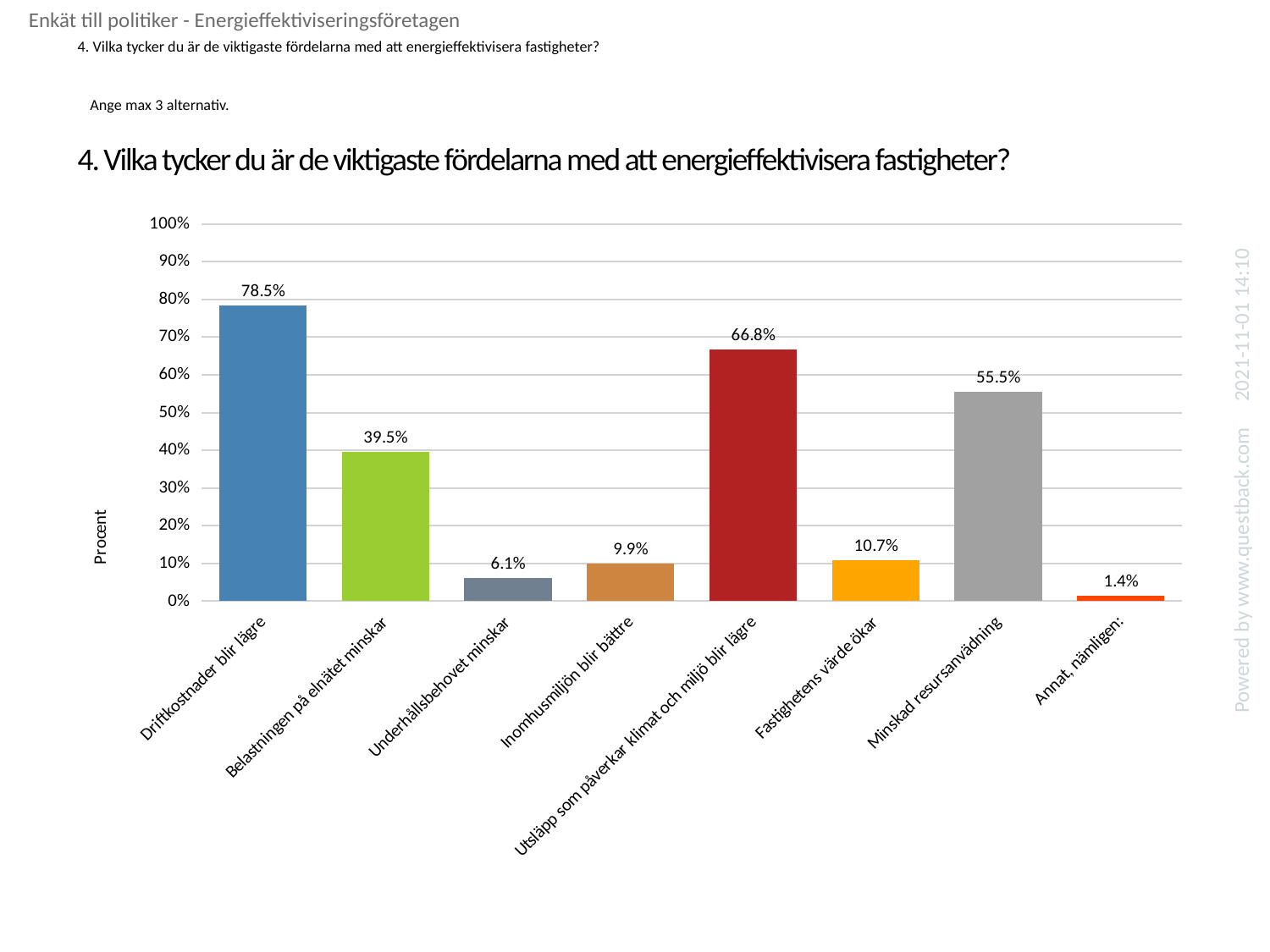
What is the label of the y axis? Procent What is the difference between "Driftkostnader blir lägre" and "Utsläpp som påverkar klimat och miljö blir lägre"? 11.7% Is the value for "Minskad resursanvädning" greater or less than 50%? greater Which category has the highest value? Driftkostnader blir lägre What is the value for "Fastighetens värde ökar"? 10.7% What is the value for "Driftkostnader blir lägre"? 78.5% Which is larger: "Belastningen på elnätet minskar" or "Minskad resursanvädning"? Minskad resursanvädning What is the value for "Utsläpp som påverkar klimat och miljö blir lägre"? 66.8% What is the difference between "Inomhusmiljön blir bättre" and "Underhållsbehovet minskar"? 3.8% How many categories are shown on the x axis? 8 What kind of chart is shown on the slide? bar chart Which category has the lowest value? Annat, nämligen: